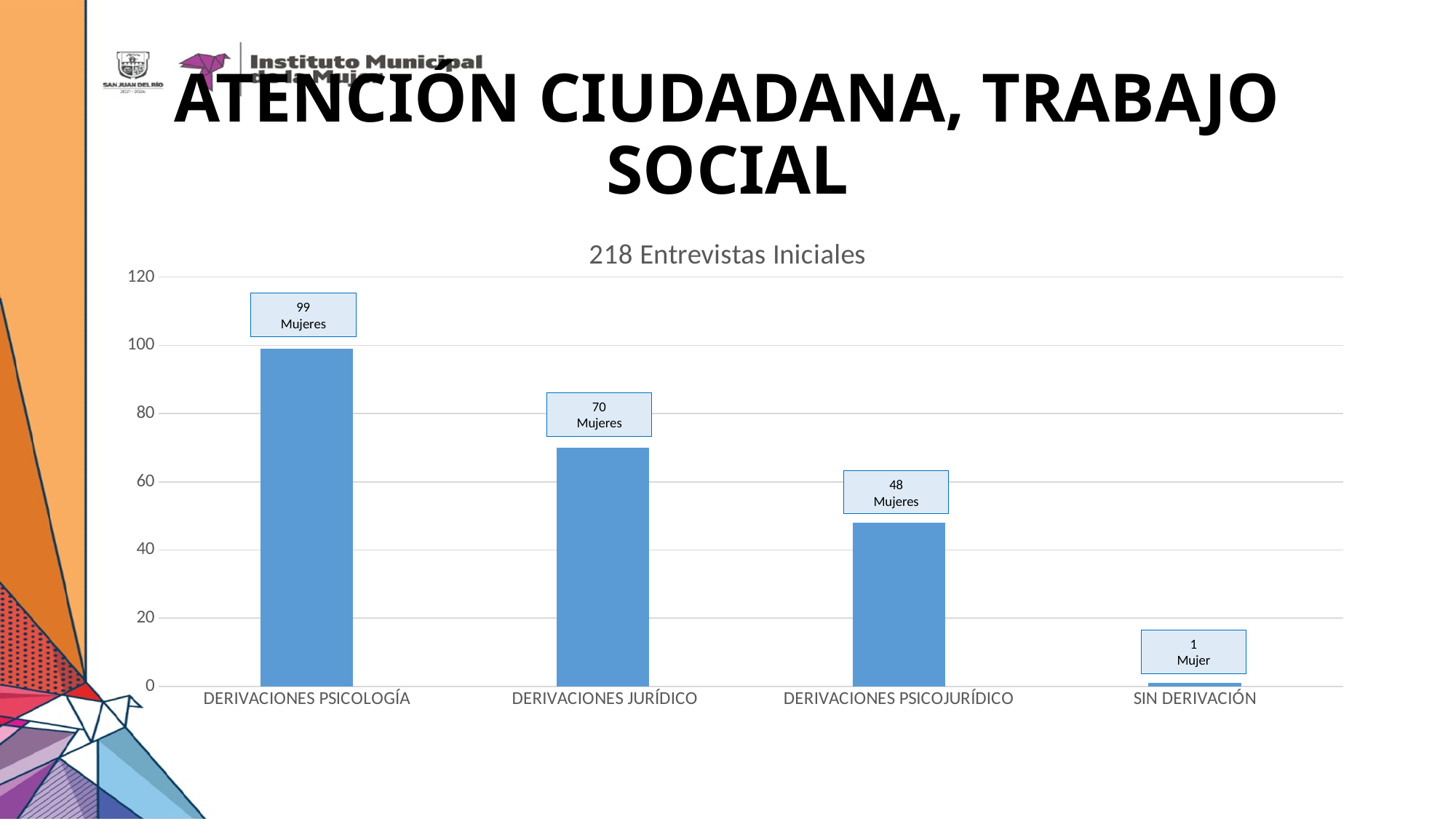
What kind of chart is shown on the slide? bar chart How many categories are shown on the x axis? 4 What is the difference between the values for DERIVACIONES PSICOLOGÍA and DERIVACIONES JURÍDICO? 29 What is the value for DERIVACIONES JURÍDICO? 70 Which is larger, the value for DERIVACIONES JURÍDICO or DERIVACIONES PSICOJURÍDICO? DERIVACIONES JURÍDICO What is the value for DERIVACIONES PSICOLOGÍA? 99 What is the value for DERIVACIONES PSICOJURÍDICO? 48 Which category has the highest value? DERIVACIONES PSICOLOGÍA What is the title of the chart? 218 Entrevistas Iniciales Is the value for DERIVACIONES PSICOJURÍDICO greater or less than 60? less What is the value for SIN DERIVACIÓN? 1 Which category has the lowest value? SIN DERIVACIÓN